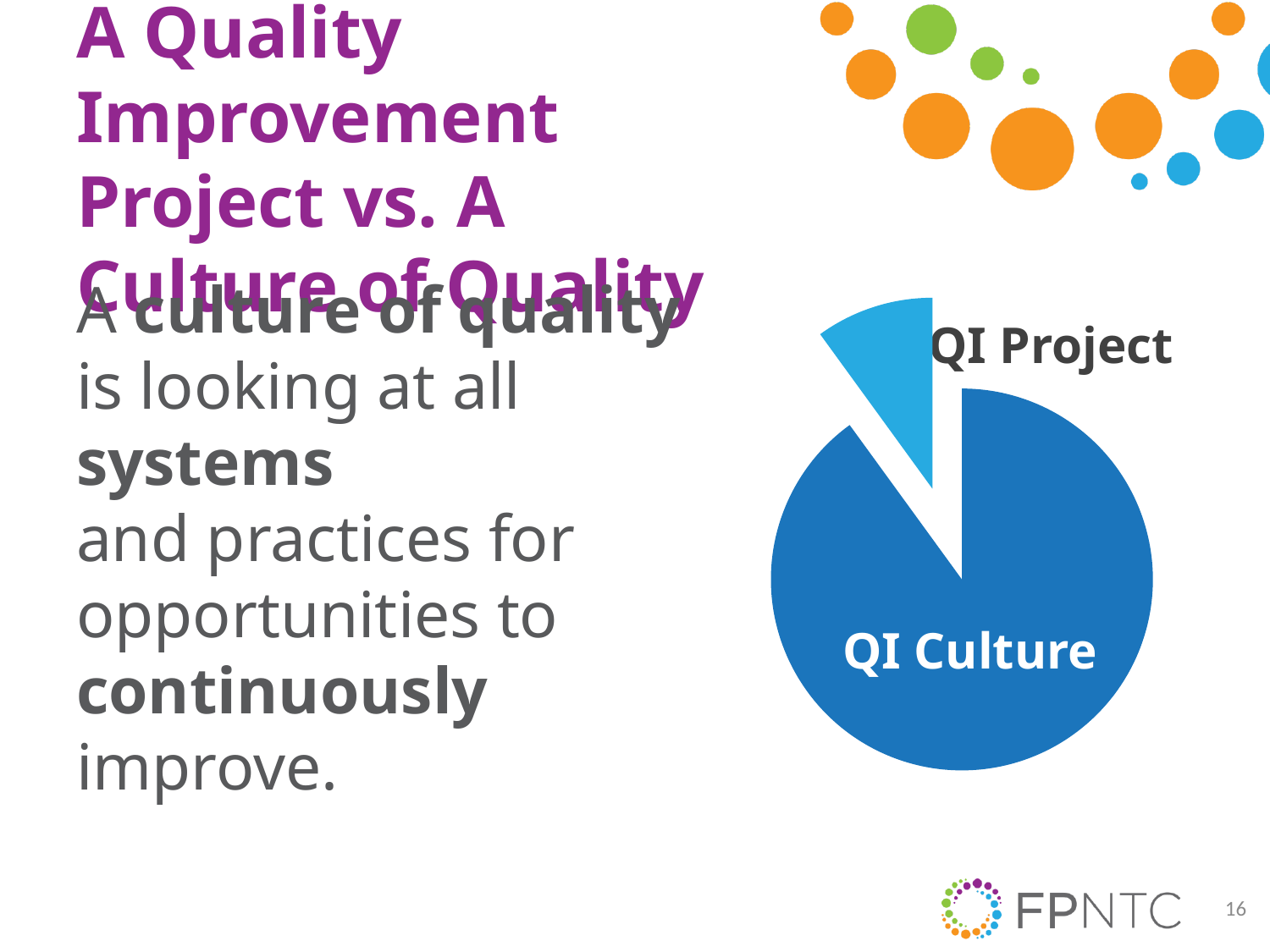
What are the labels of the two slices in the pie chart? QI Project and QI Culture Which slice of the pie chart is pulled out (exploded) from the rest of the pie? QI Project Which slice of the pie chart is the smallest? QI Project Which slice of the pie chart is the largest? QI Culture What kind of chart is shown on the slide? pie chart How many slices does the pie chart have? 2 Which slice is larger, QI Project or QI Culture? QI Culture